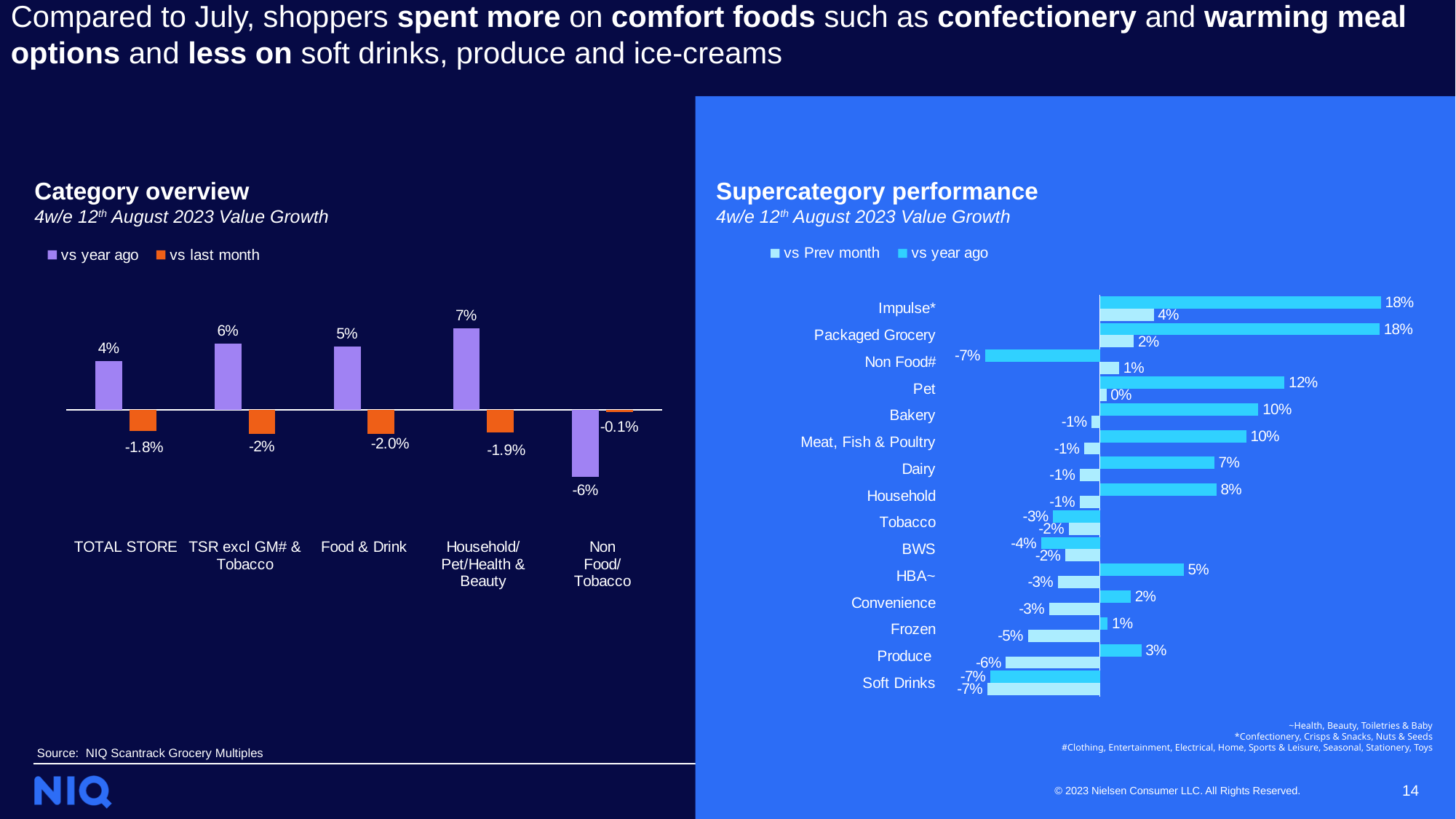
In the "Category overview" chart, what is the difference between the vs year ago values for TSR excl GM# & Tobacco and Food & Drink? 1 percentage point How many series does the legend of the "Supercategory performance" chart list? 2 In the "Supercategory performance" chart, what is the vs Prev month value for Soft Drinks? -7% In the "Category overview" chart, what is the vs last month value for TOTAL STORE? -1.8% In the "Supercategory performance" chart, which has the larger vs year ago value, Bakery or Dairy? Bakery In the "Supercategory performance" chart, what is the vs year ago value for Pet? 12% In the "Category overview" chart, which category has the lowest vs year ago value? Non Food/Tobacco How many supercategories are shown in the "Supercategory performance" chart? 15 In the "Category overview" chart, what is the vs year ago value for Household/Pet/Health & Beauty? 7% How many categories are shown in the "Category overview" chart? 5 What kind of chart is the "Category overview" chart? Bar chart In the "Category overview" chart, which category has the highest vs year ago value? Household/Pet/Health & Beauty